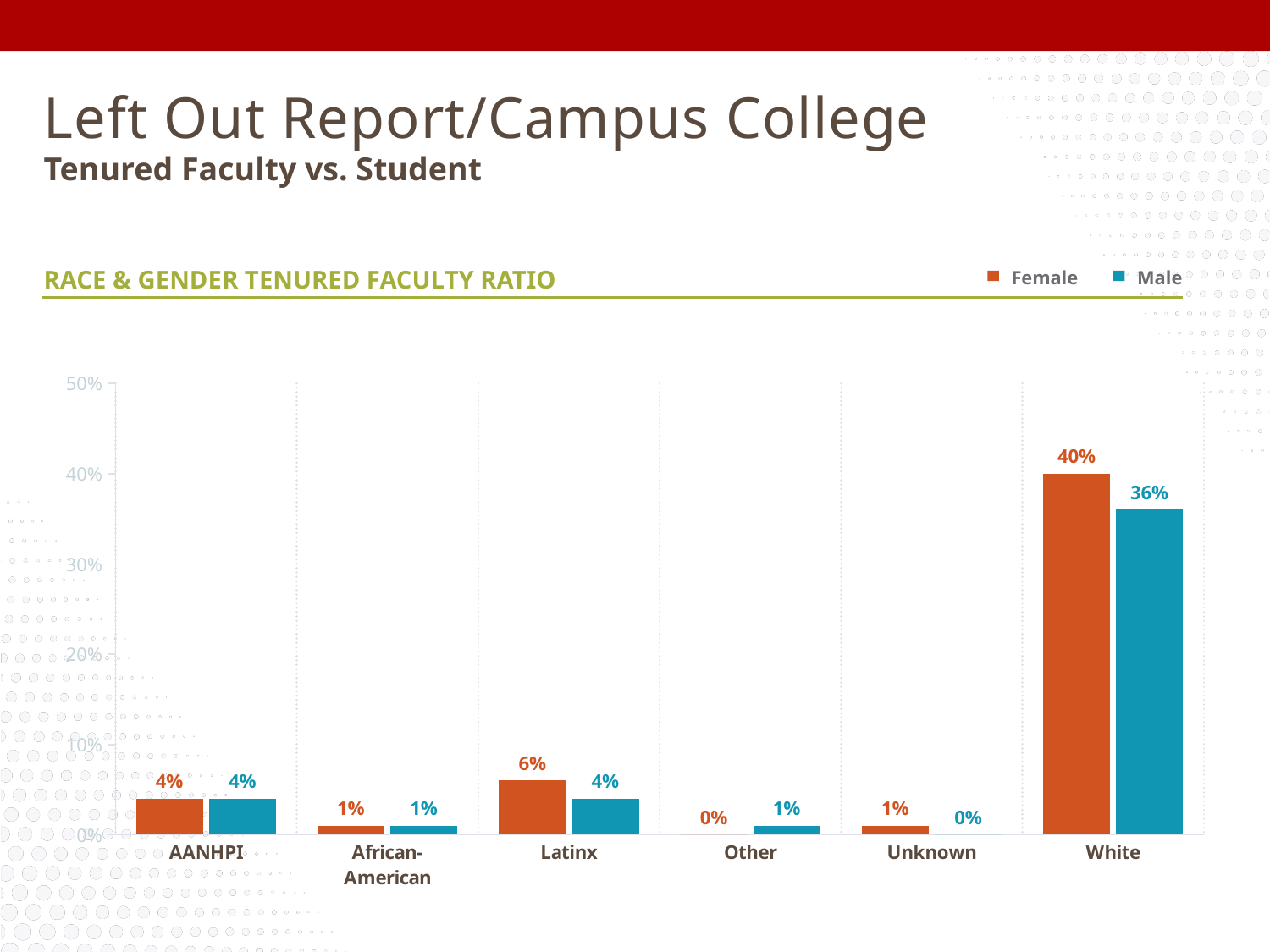
What is the Female tenured faculty ratio for White? 40% What is the title of the chart? RACE & GENDER TENURED FACULTY RATIO What is the Female value for Latinx? 6% How many race categories are shown on the x axis? 6 What is the difference between the Female and Male values for White? 4% How many series does the legend list? 2 What is the Male value for Unknown? 0% What is the Male tenured faculty ratio for Latinx? 4% Which category has the highest Male value? White What kind of chart is shown on the slide? Bar chart Which is larger for Latinx, the Female value or the Male value? Female Which category has the lowest Female value? Other